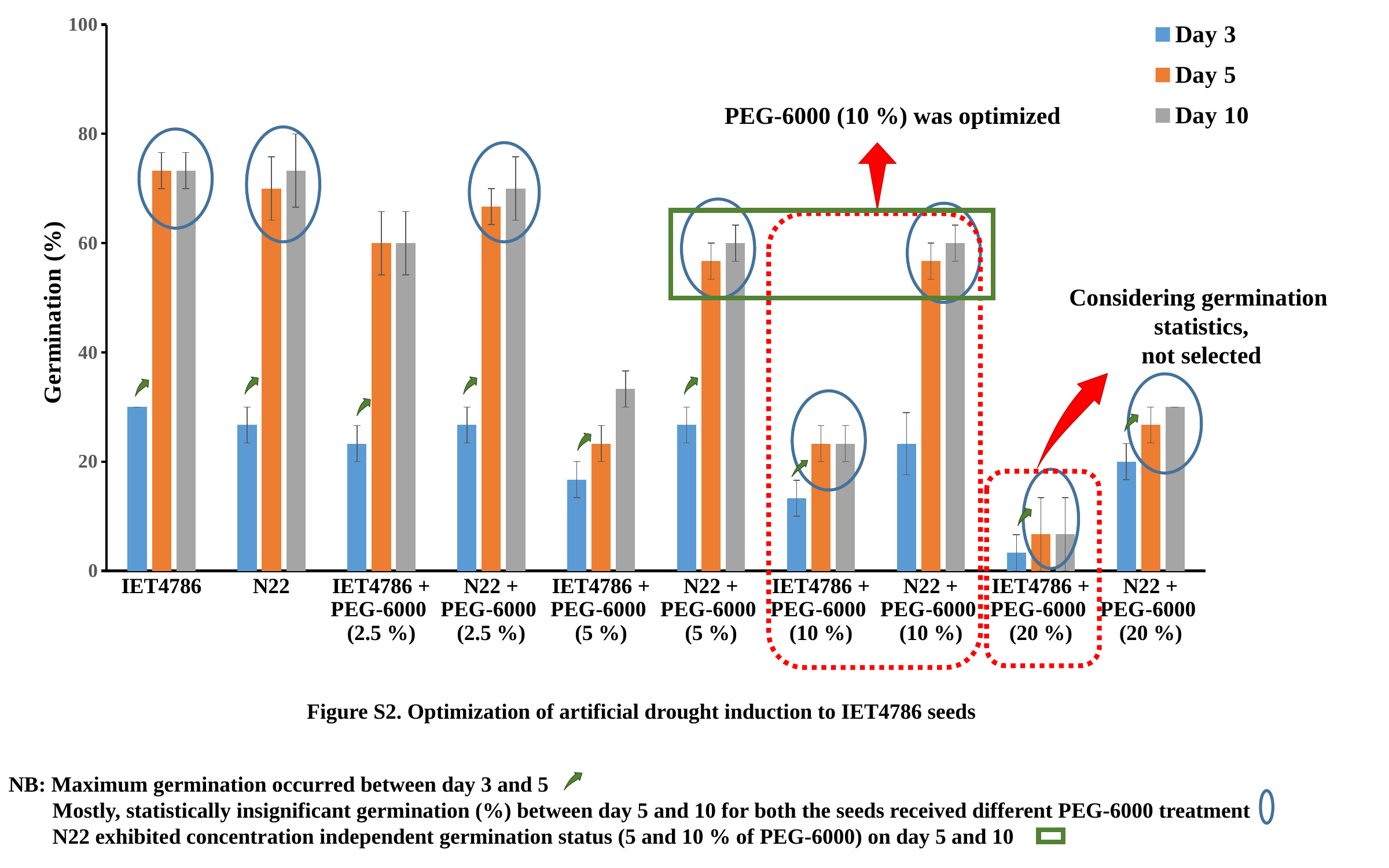
How many series does the legend list? 3 Is the Day 3 value for IET4786 + PEG-6000 (20 %) greater or less than 20? less Is the Day 5 value for IET4786 greater or less than 60? greater What is the Day 10 value for IET4786 + PEG-6000 (2.5 %)? 60 Across the IET4786 groups, as the PEG-6000 concentration increases from 0 to 20 %, do the Day 3 values rise or fall? fall What kind of chart is shown on the slide? bar chart What is the Day 3 value for N22 + PEG-6000 (20 %)? 20 How many categories are shown along the x axis? 10 What is the label of the y axis? Germination (%) Is the Day 10 value for IET4786 + PEG-6000 (5 %) greater or less than 40? less Which is larger, the Day 3 value for IET4786 or the Day 3 value for IET4786 + PEG-6000 (10 %)? IET4786 Which category has the lowest Day 3 value? IET4786 + PEG-6000 (20 %)